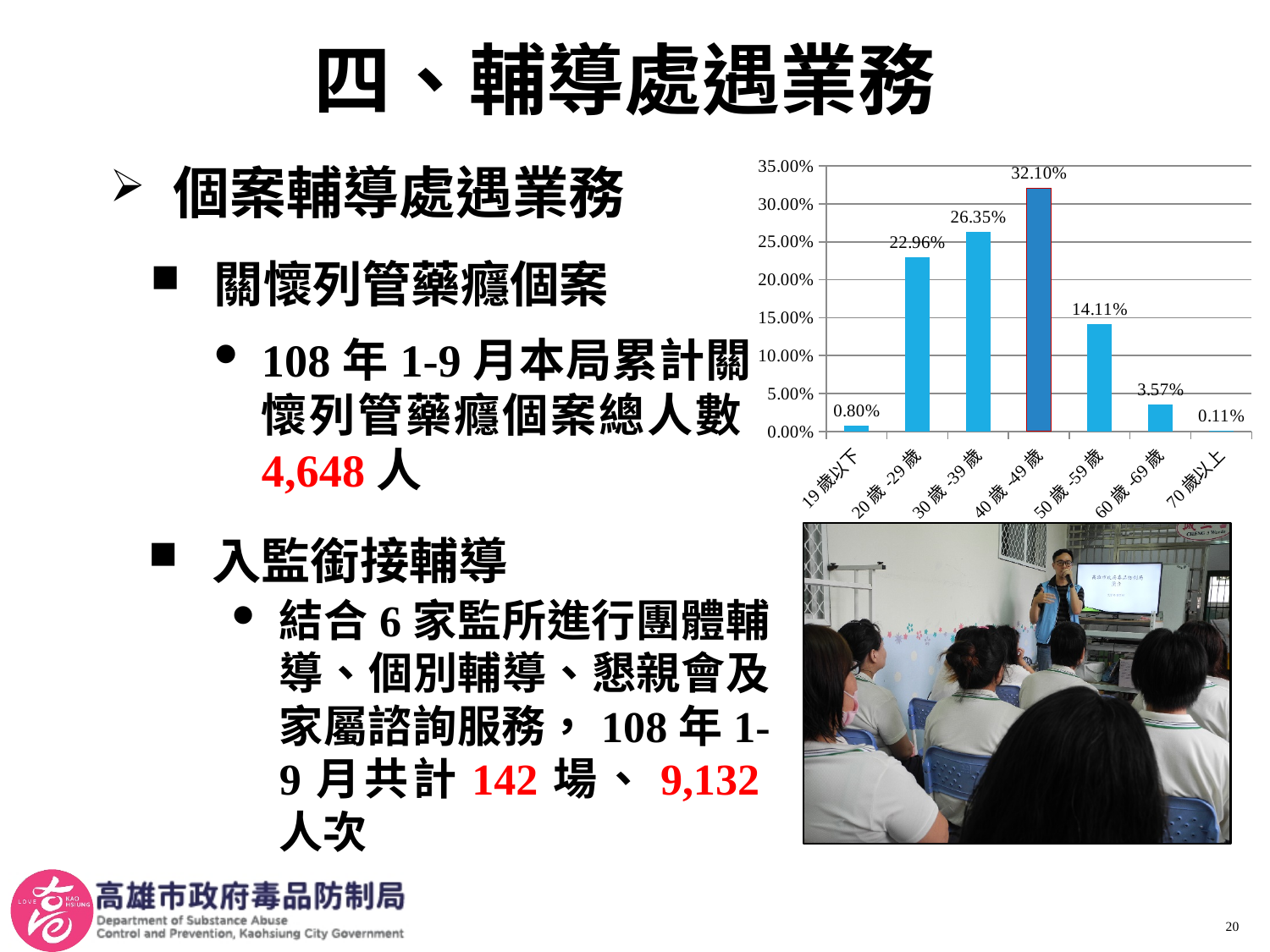
Which age group has the highest value? 40歲-49歲 How many age groups are shown on the chart? 7 What kind of chart is shown on the slide? bar chart Which is larger, the value for 20歲-29歲 or the value for 50歲-59歲? 20歲-29歲 What is the value for the 40歲-49歲 age group? 32.10% What is the difference between the values for 50歲-59歲 and 60歲-69歲? 10.54% Which age group has the lowest value? 70歲以上 What is the difference between the values for 40歲-49歲 and 30歲-39歲? 5.75% What is the value for the 60歲-69歲 age group? 3.57% Is the value for 30歲-39歲 greater or less than 25.00%? greater What is the value for the 20歲-29歲 age group? 22.96% What is the value for the 70歲以上 age group? 0.11%